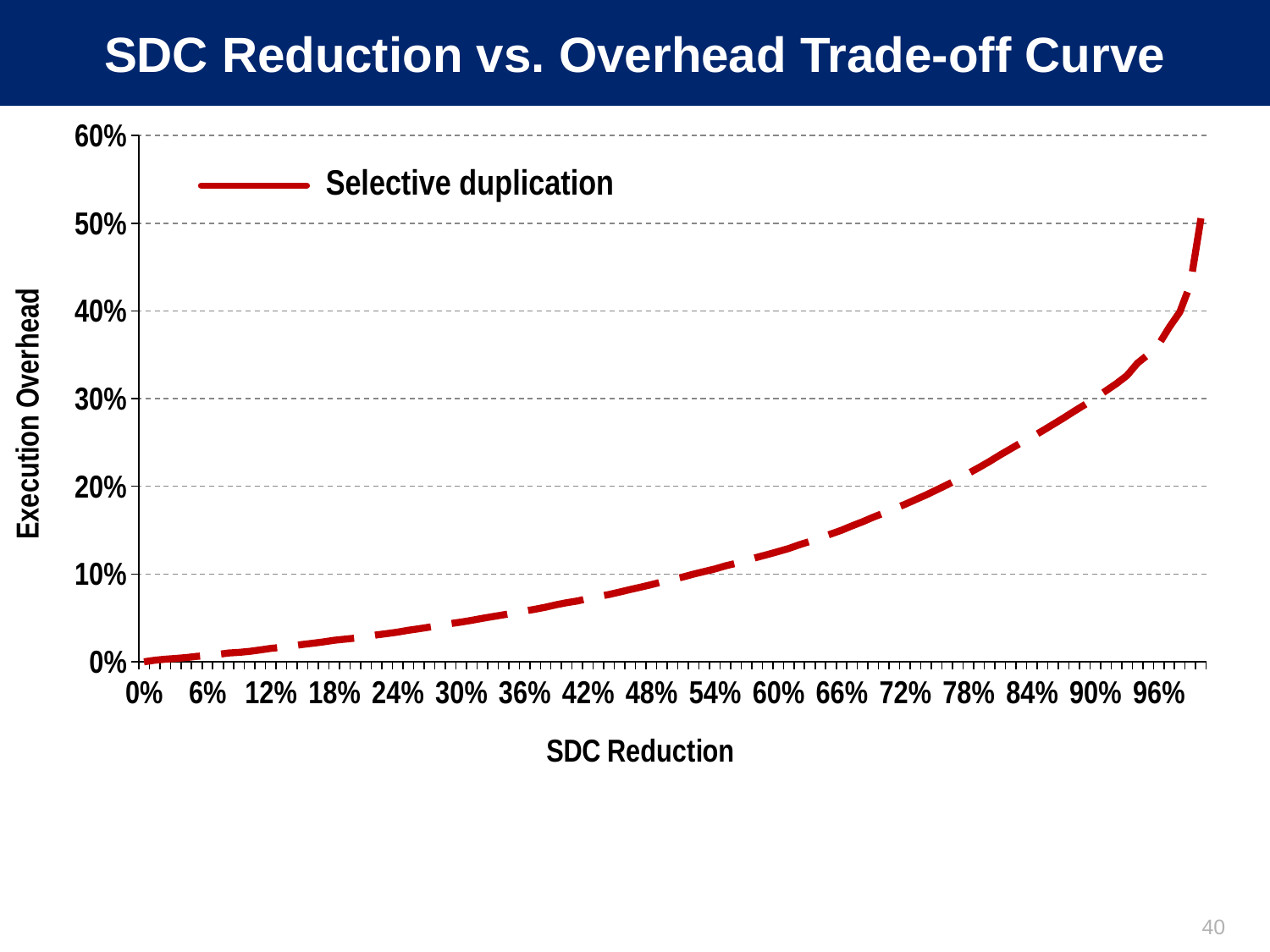
Is the execution overhead at 48% SDC reduction greater or less than 10%? less Is the highest execution overhead reached by the curve greater or less than 60%? less What is the title of the chart? SDC Reduction vs. Overhead Trade-off Curve Does the execution overhead rise or fall as SDC reduction increases along the x axis? rise Is the execution overhead at 84% SDC reduction greater or less than 20%? greater What kind of chart is shown on the slide? line chart How many series does the legend list? 1 What is the name of the series shown in the legend? Selective duplication